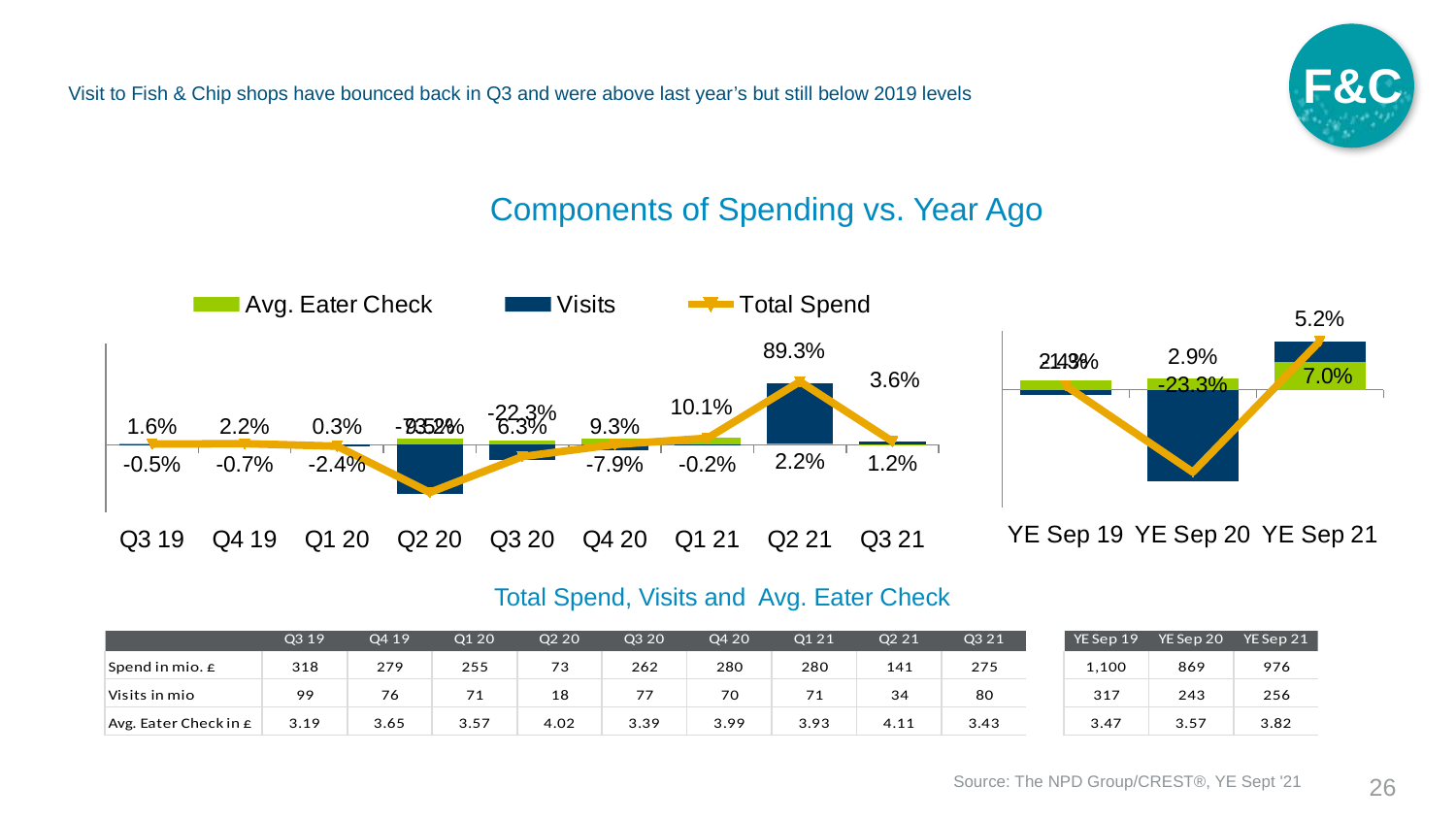
In the left-hand quarterly chart, what is the Visits value for Q2 21? 89.3% In the left-hand quarterly chart, how many quarters are shown on the x axis? 9 In the left-hand quarterly chart, which quarter has the tallest Visits bar? Q2 21 In the left-hand quarterly chart, which quarter has the lowest Visits bar? Q2 20 In the right-hand year-ending chart, what is the Avg. Eater Check value for YE Sep 21? 7.0% How many series does the chart legend list? 3 What kind of chart is the left-hand chart? Bar chart with a line What is the title of the chart on the slide? Components of Spending vs. Year Ago In the right-hand year-ending chart, how many categories are shown on the x axis? 3 Which series in the legend is shown as a line rather than bars? Total Spend In the right-hand year-ending chart, what is the Visits value for YE Sep 20? -23.3%